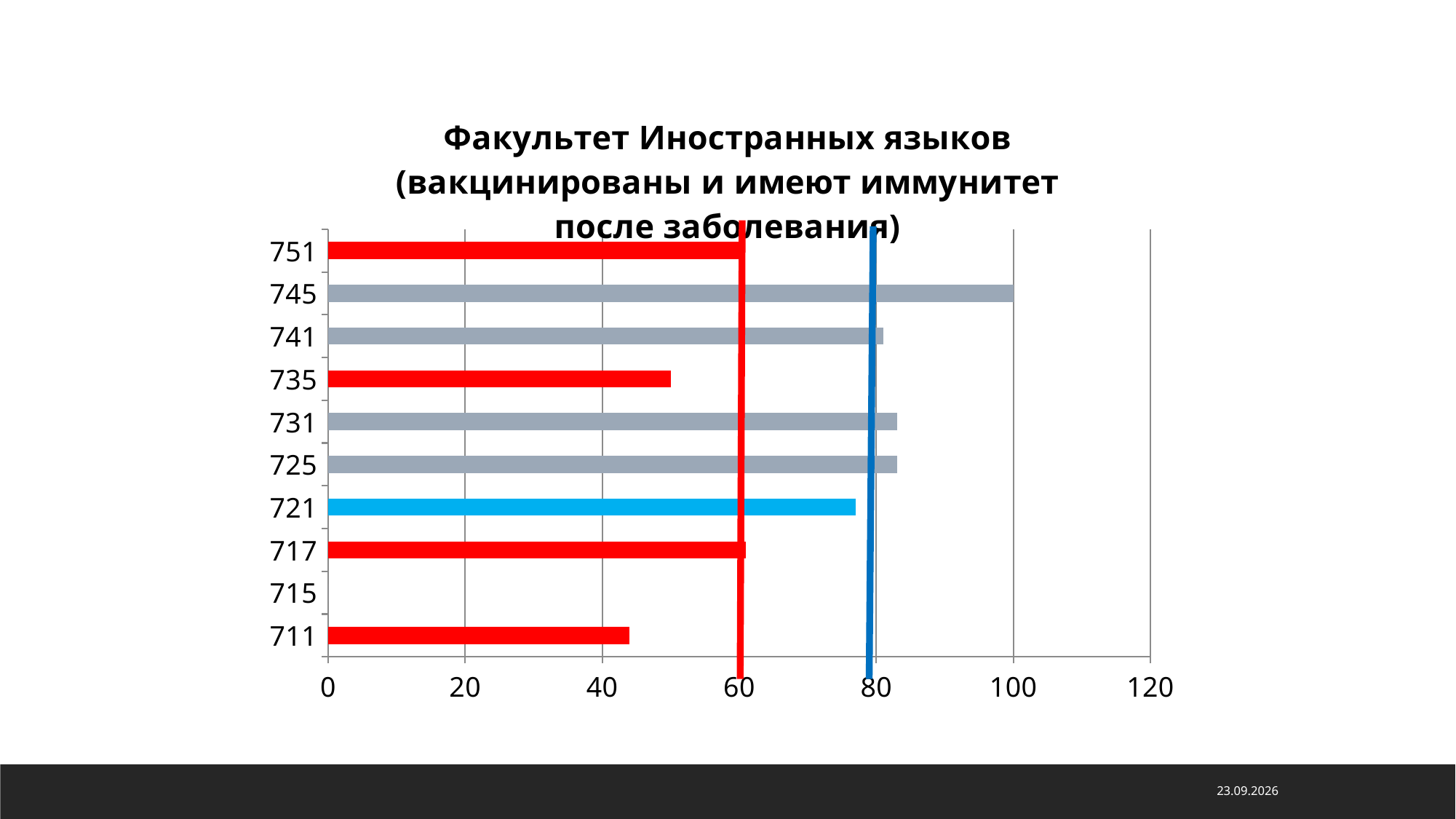
Which has the larger value, 745 or 735? 745 At which two values on the horizontal axis are vertical reference lines drawn? 60 and 80 Is the value for 721 greater or less than 80? less What is the value for category 745? 100 Is the value for 741 greater or less than 60? greater Which has the larger value, 735 or 711? 735 Which category on the vertical axis has no bar shown? 715 Which category has the longest bar in the chart? 745 Is the value for 735 greater or less than 60? less What kind of chart is shown on the slide? bar chart How many categories are listed on the vertical axis of the chart? 10